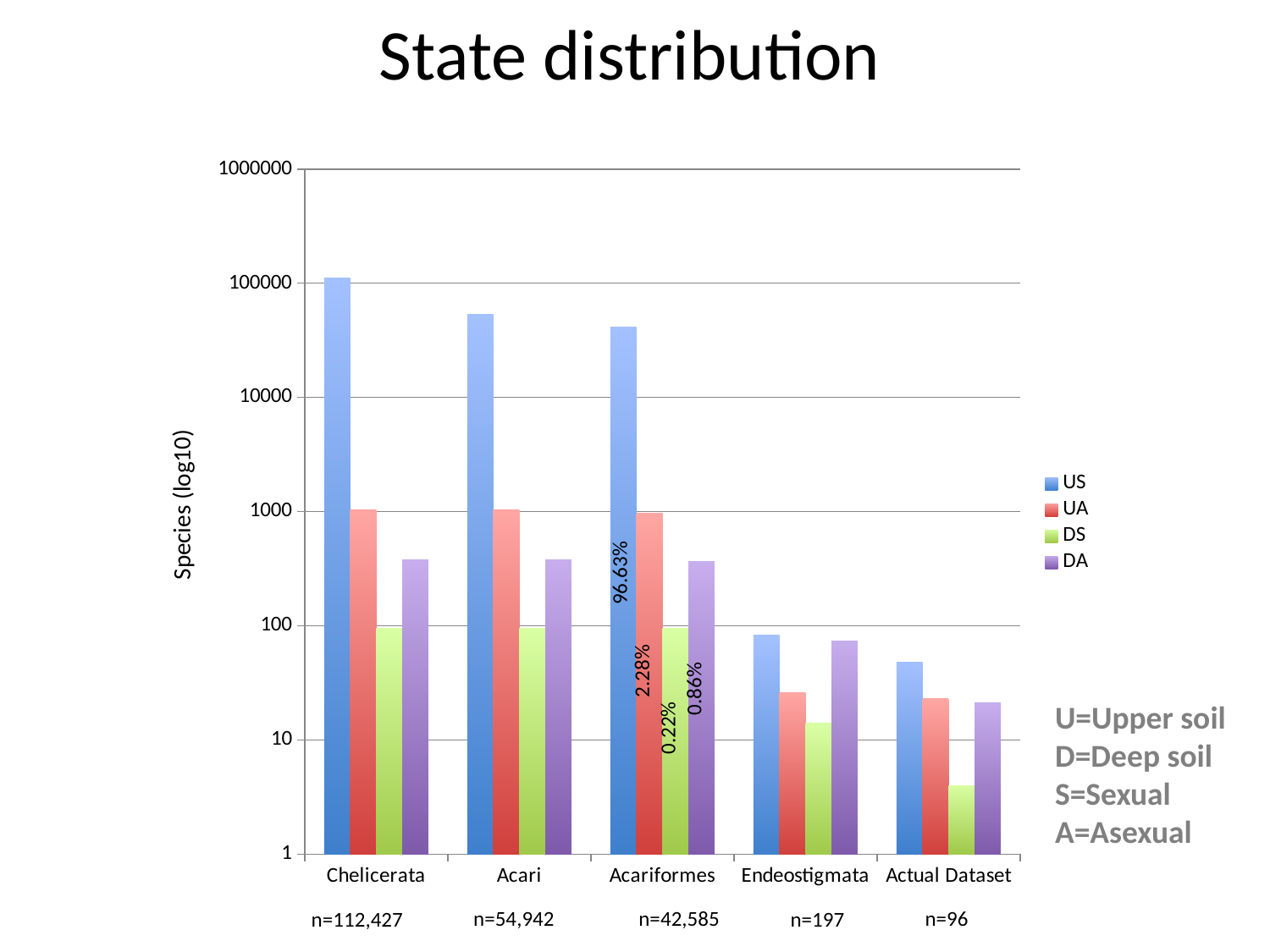
Is the US value for Chelicerata greater or less than 10000? greater What percentage label is printed on the DA bar for Acariformes? 0.86% Is the DS value for Actual Dataset greater or less than 10? less What percentage label is printed on the US bar for Acariformes? 96.63% For Endeostigmata, which is larger, the UA bar or the DA bar? DA Which series has the highest bar for Chelicerata? US How many categories are shown along the x axis? 5 What kind of chart is shown on the slide? bar chart How many series does the legend list? 4 Which series has the lowest bar for Actual Dataset? DS What percentage label is printed on the DS bar for Acariformes? 0.22% Do the US values rise or fall moving from Chelicerata to Actual Dataset? fall